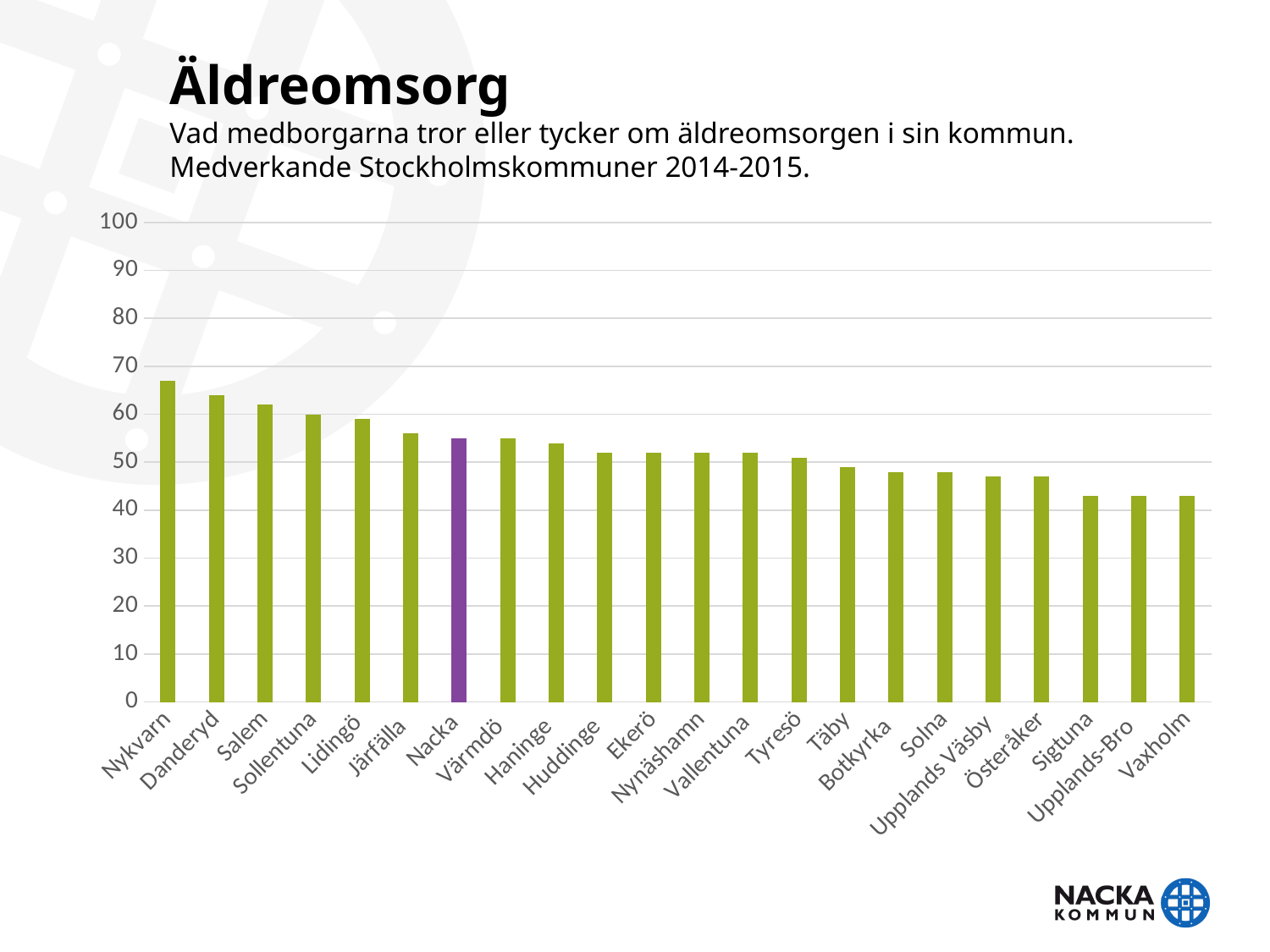
Do the values rise or fall from left to right along the x axis? fall Which municipality has the highest value in the chart? Nykvarn Is the value for Nykvarn greater or less than 60? greater Is the value for Sigtuna greater or less than 50? less Which has the larger value, Danderyd or Nacka? Danderyd Which municipality's bar is shown in a different colour (purple) from the others? Nacka Is the value for Lidingö greater or less than 50? greater What kind of chart is shown on the slide? bar chart How many municipalities are shown on the x axis of the chart? 22 Which has the larger value, Salem or Upplands-Bro? Salem